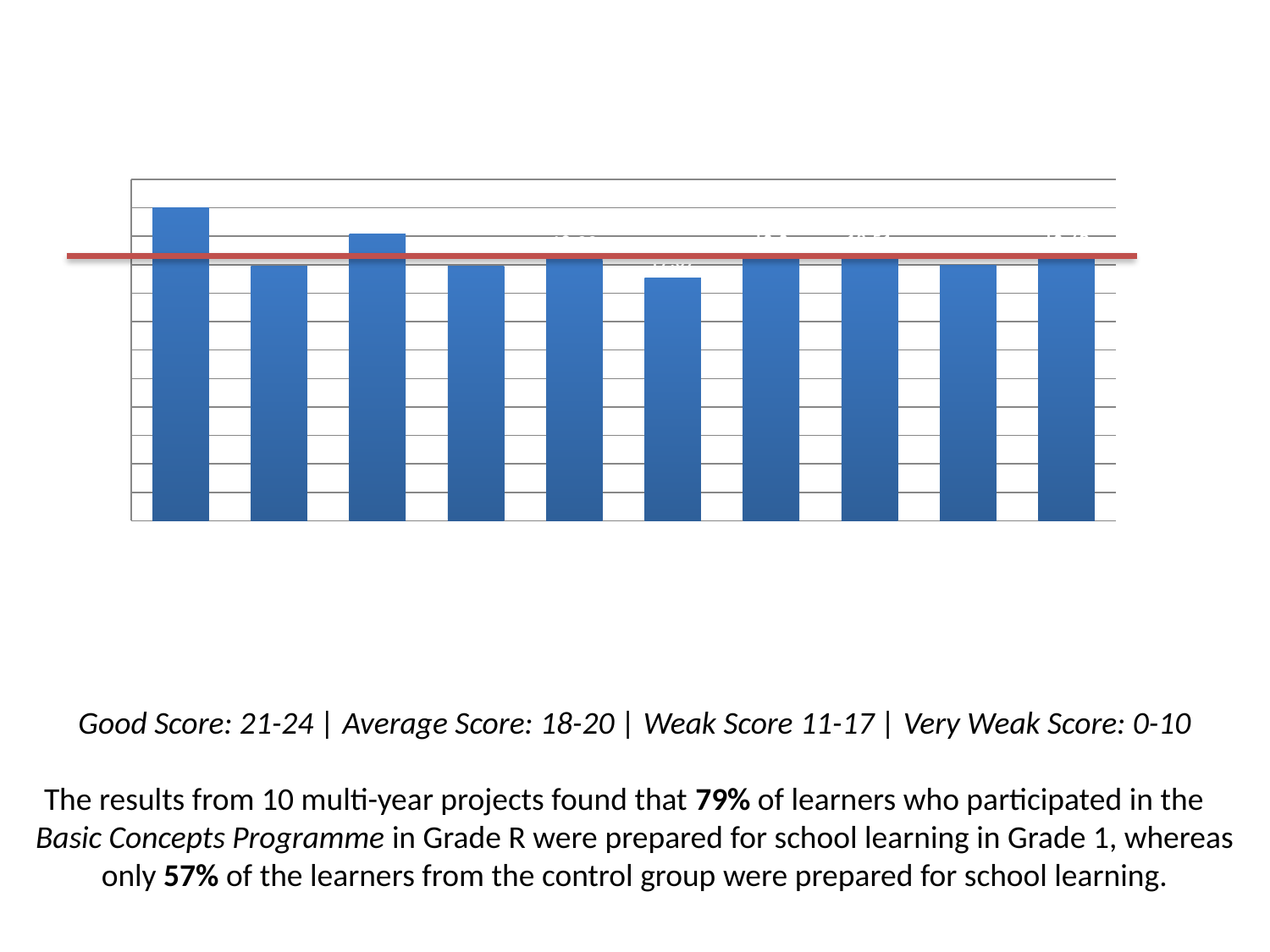
How many bars are plotted in the chart? 10 What colour are the bars in the chart? blue Which bar in the chart is the shortest? the sixth bar from the left What kind of chart is shown on the slide? bar chart Is the first bar from the left taller or shorter than the second bar? taller Is the third bar from the left taller or shorter than the sixth bar? taller Is the sixth bar from the left taller or shorter than the seventh bar? shorter Which bar in the chart is the tallest? the first bar (leftmost) What colour is the horizontal line drawn across the chart? red